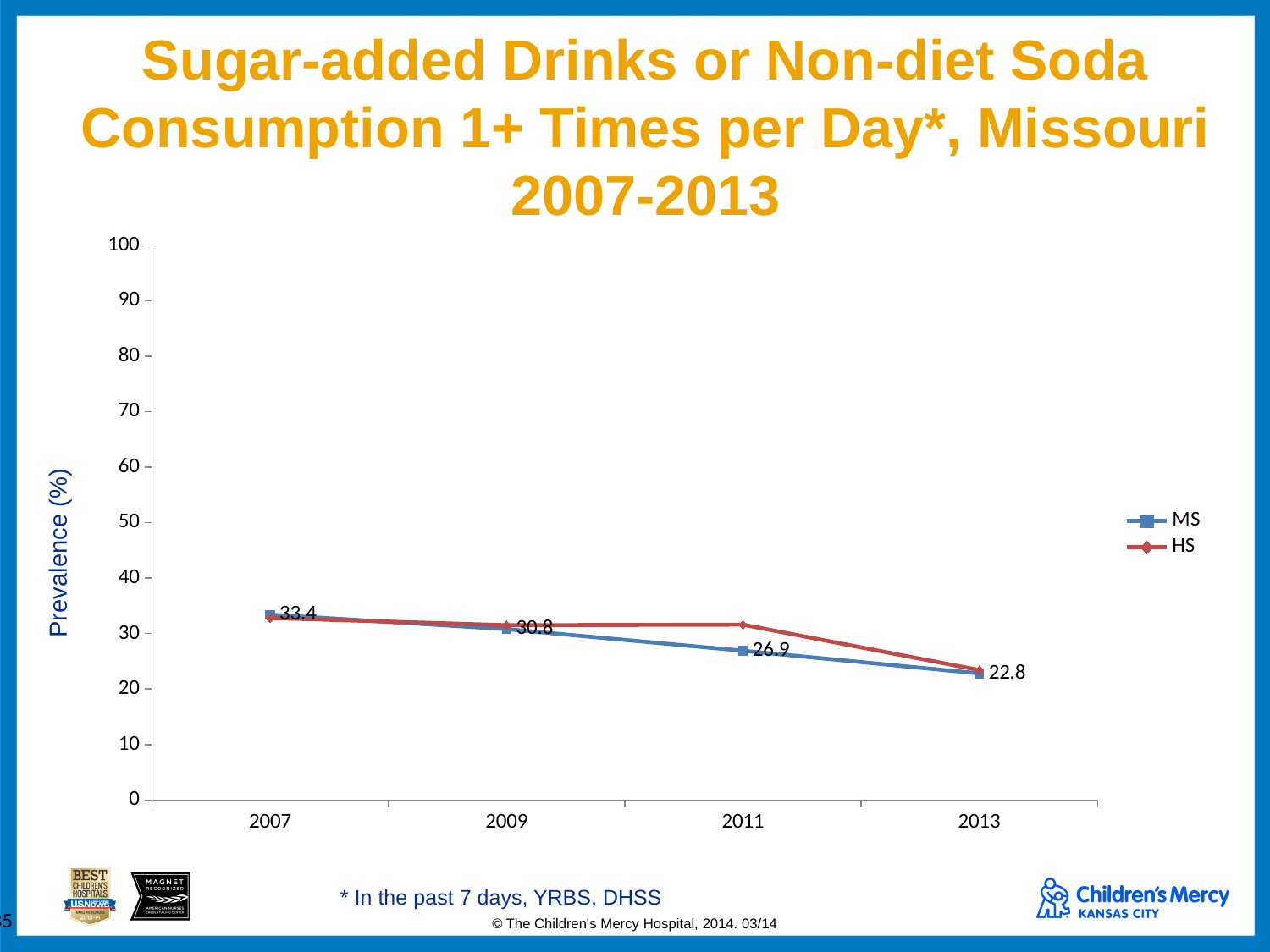
In which year is the MS value highest? 2007 How many years are plotted on the x axis? 4 What is the MS value for 2011? 26.9 What is the MS value for 2013? 22.8 Is the HS value for 2011 greater or less than 30? greater What is the MS value for 2009? 30.8 How many series does the legend list? 2 What is the difference between the MS values for 2007 and 2013? 10.6 In 2011, which series has the higher value, MS or HS? HS What is the MS value for 2007? 33.4 What kind of chart is shown on the slide? Line chart In which year is the MS value lowest? 2013